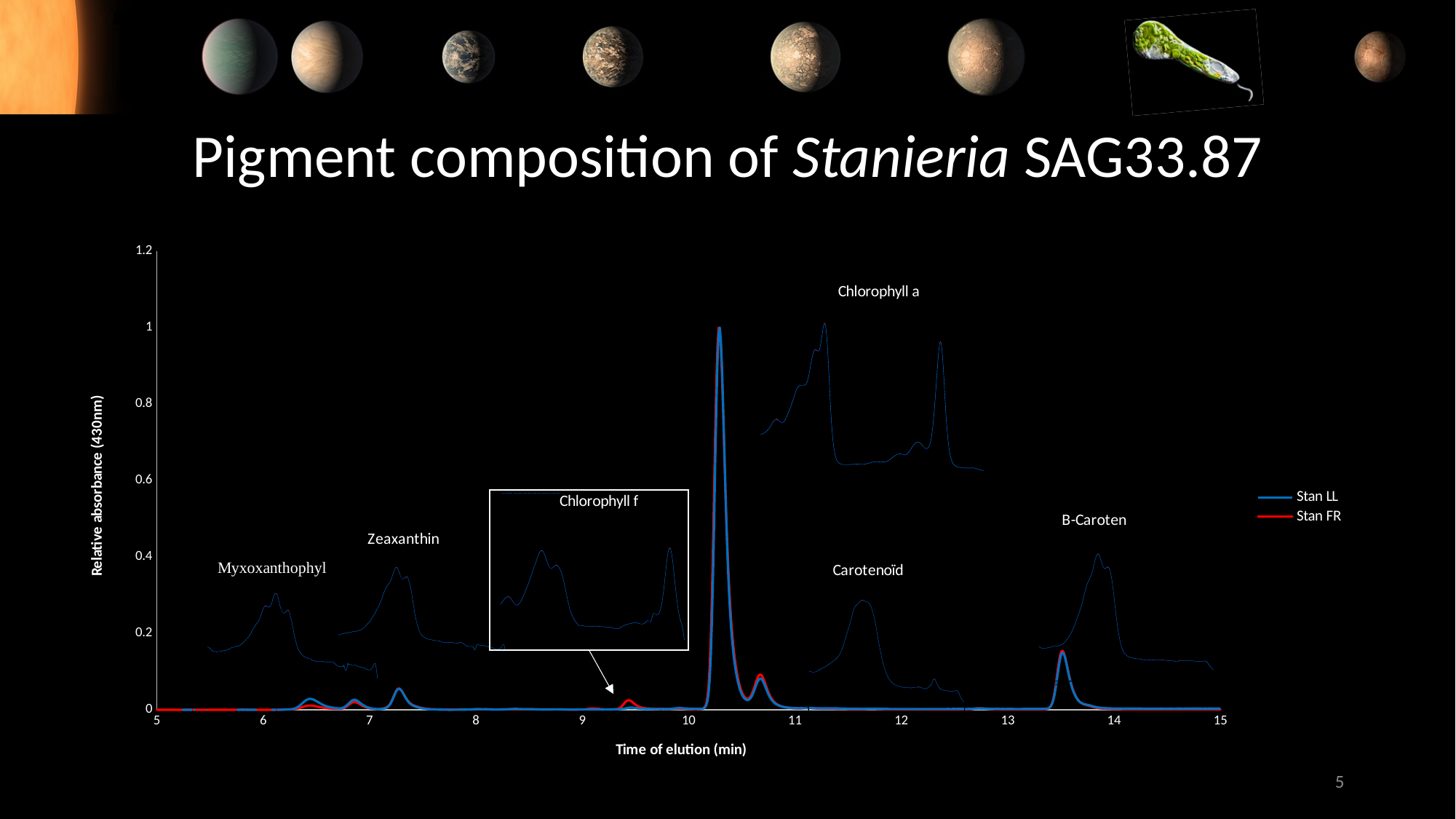
Which series is drawn in red according to the legend? Stan FR Is the value of the peak between 7 and 8 min greater or less than 0.2? less What is the title of the x axis? Time of elution (min) What is the lowest time shown on the x axis? 5 What is the highest value shown on the y axis? 1.2 What kind of chart is shown on the slide? Line chart Between which two x-axis ticks does the highest peak of the chromatogram occur? 10 and 11 How many series does the legend list? 2 Is the value of the peak just after 13 min greater or less than 0.2? less Is the value of the tallest peak (between 10 and 11 min) greater or less than 0.8? greater How many pigment names are annotated on the chart? 6 Which is larger: the peak between 10 and 11 min or the peak between 13 and 14 min? The peak between 10 and 11 min